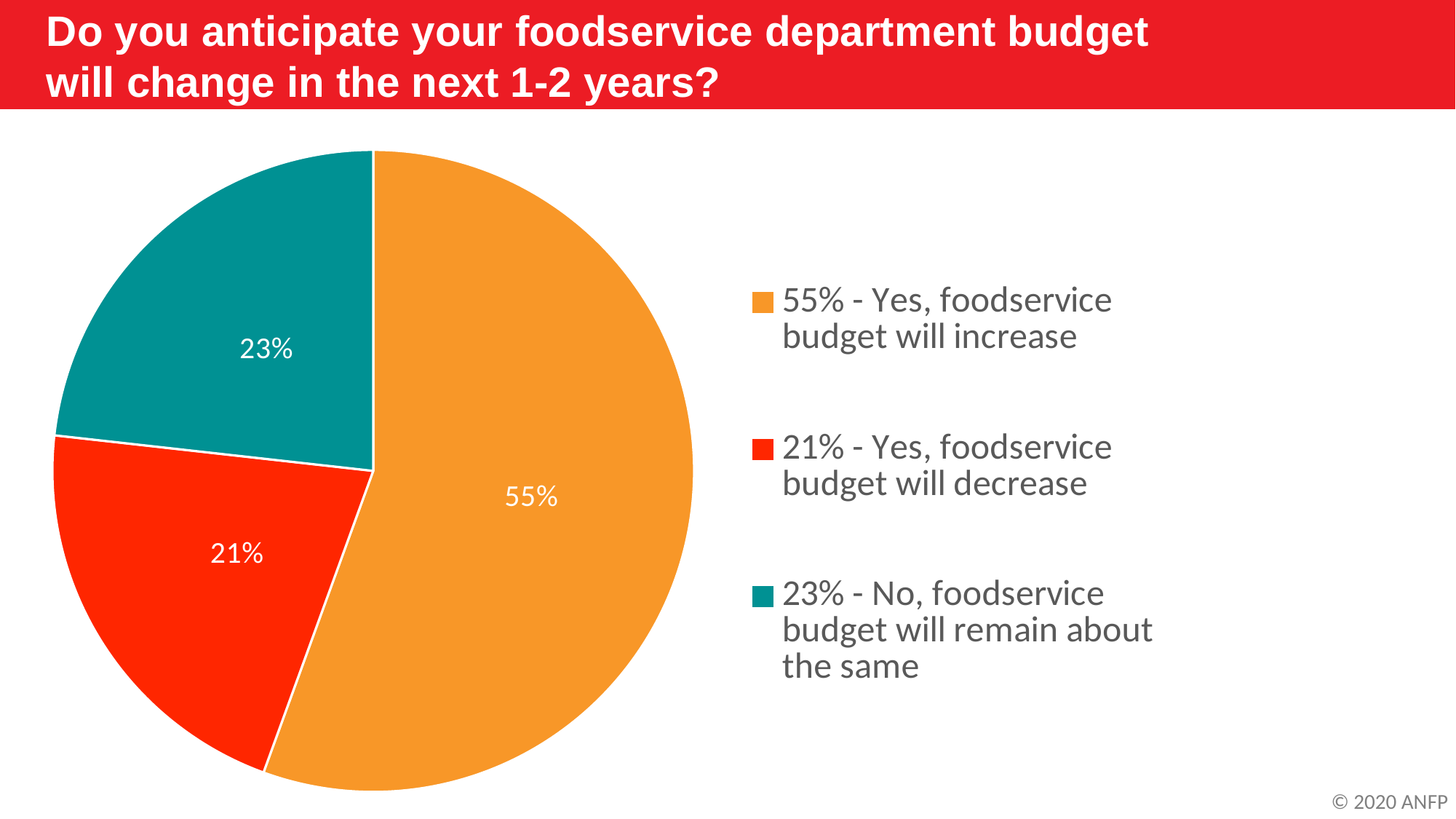
What is the difference in percentage points between the 'remain about the same' slice and the 'budget will decrease' slice? 2 What is the difference in percentage points between the 'budget will increase' slice and the 'budget will decrease' slice? 34 Which is larger: the share saying the budget will remain about the same or the share saying it will decrease? remain about the same What share of respondents said their foodservice budget will decrease? 21% What share of respondents said their foodservice budget will remain about the same? 23% How many slices does the pie chart have? 3 What share of respondents said their foodservice budget will increase? 55% What colour is the slice for 'No, foodservice budget will remain about the same'? teal What kind of chart is shown on the slide? pie chart Which response has the smallest slice of the pie? Yes, foodservice budget will decrease What colour is the slice for 'Yes, foodservice budget will decrease'? red Which response has the largest slice of the pie? Yes, foodservice budget will increase